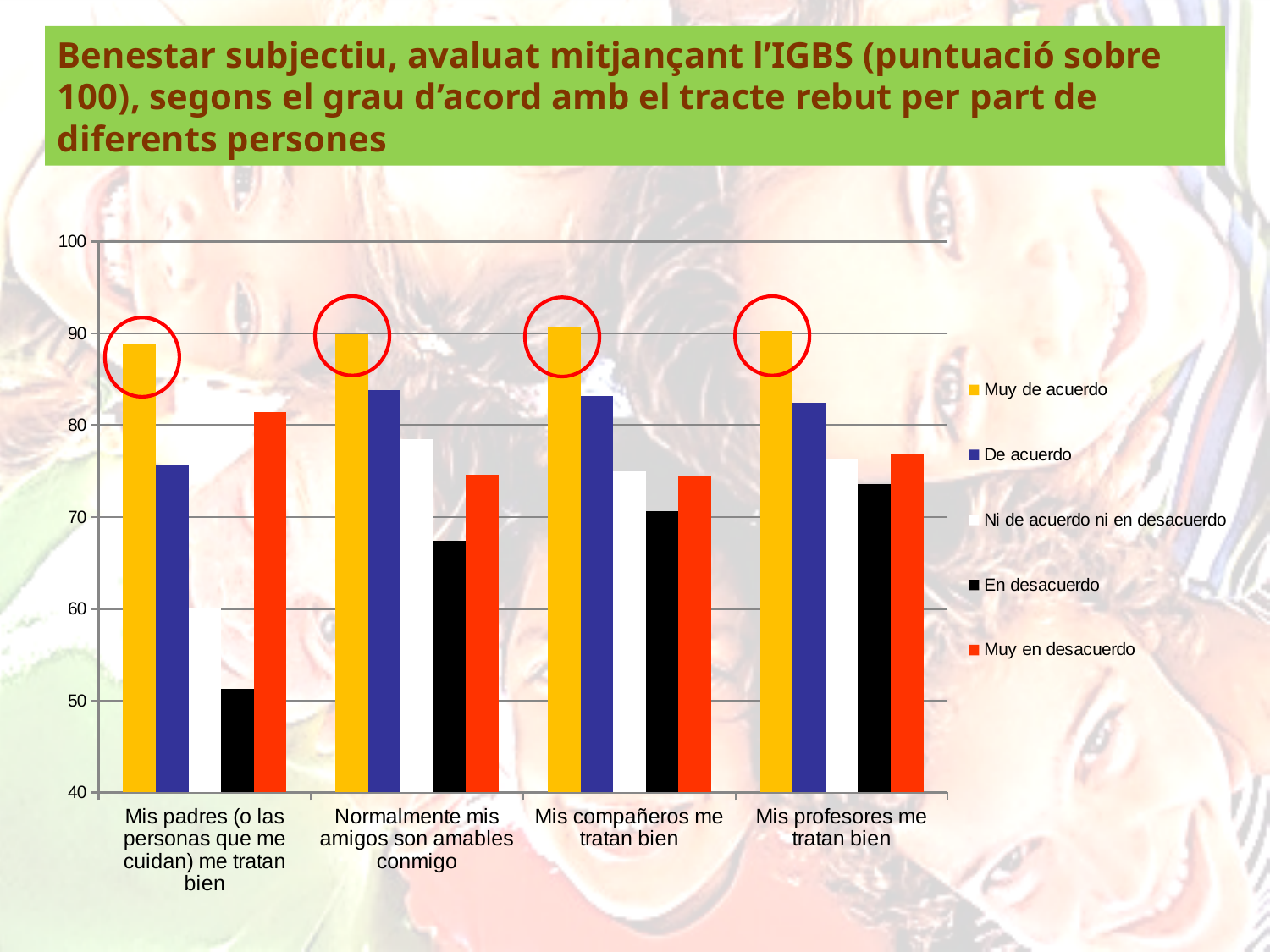
What kind of chart is shown on the slide? bar chart How many categories are shown along the x axis of the chart? 4 Which series' bars are highlighted with red circles on the chart? Muy de acuerdo In the category 'Mis padres (o las personas que me cuidan) me tratan bien', which is larger: 'De acuerdo' or 'Muy en desacuerdo'? Muy en desacuerdo Is the value for 'Muy de acuerdo' in the category 'Mis padres (o las personas que me cuidan) me tratan bien' greater or less than 80? greater Is the value for 'En desacuerdo' in the category 'Mis profesores me tratan bien' greater or less than 70? greater Is the value for 'Ni de acuerdo ni en desacuerdo' in the category 'Mis padres (o las personas que me cuidan) me tratan bien' greater or less than 70? less In the category 'Mis compañeros me tratan bien', which is larger: 'De acuerdo' or 'Ni de acuerdo ni en desacuerdo'? De acuerdo Which series has the lowest value in the category 'Mis padres (o las personas que me cuidan) me tratan bien'? En desacuerdo How many series does the chart's legend list? 5 Which series has the highest value in the category 'Mis padres (o las personas que me cuidan) me tratan bien'? Muy de acuerdo